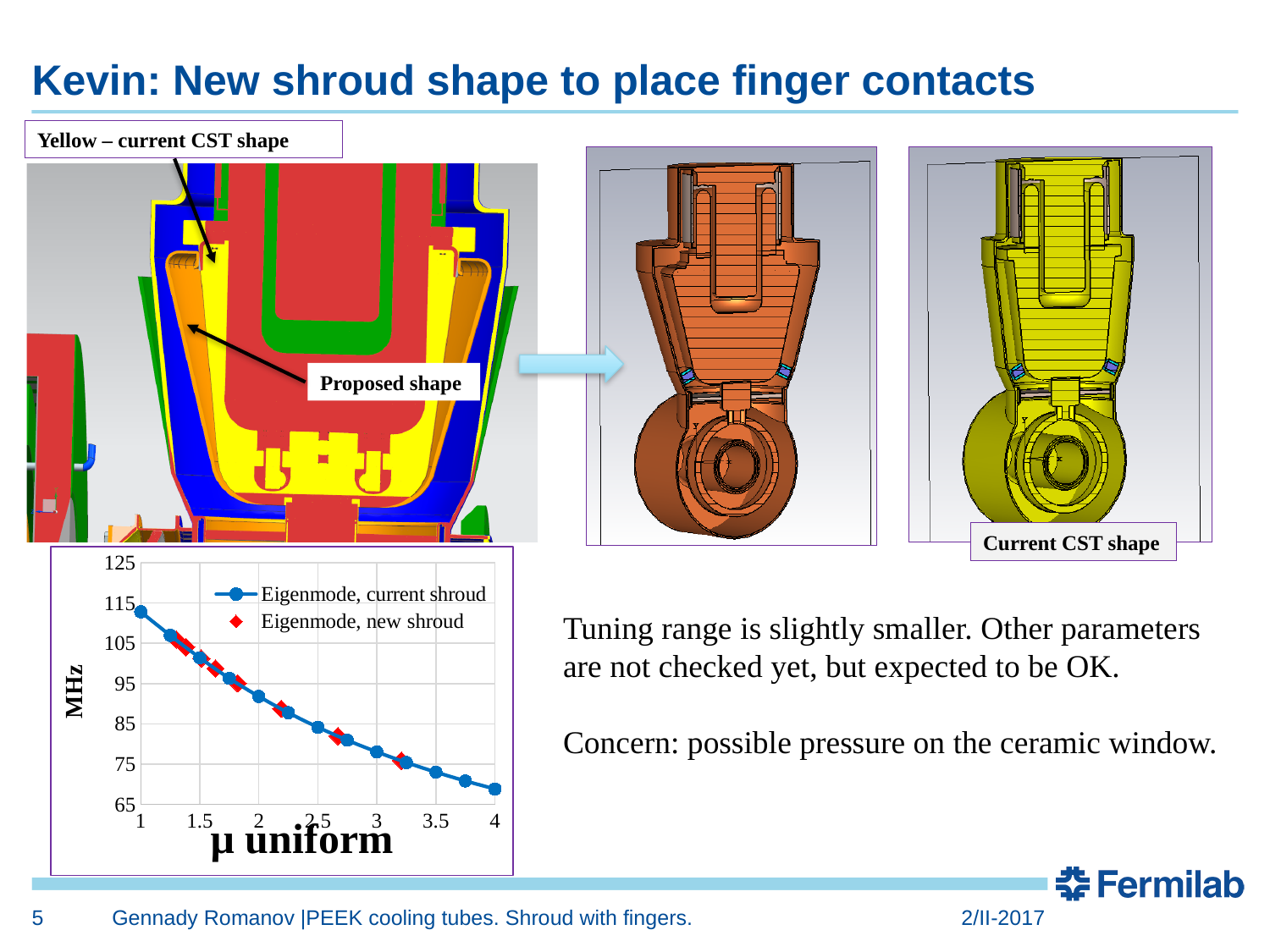
How many series does the chart legend list? 2 Which is larger for the current shroud: the value at μ uniform = 1 or at μ uniform = 4? μ uniform = 1 What kind of chart is shown on the slide? line chart Is the value for the current shroud at μ uniform = 4 greater or less than 75 MHz? less Is the value for the current shroud at μ uniform = 3 greater or less than 85 MHz? less Is the value for the current shroud at μ uniform = 1 greater or less than 105 MHz? greater What are the two series named in the chart legend? Eigenmode, current shroud; Eigenmode, new shroud At which μ uniform value does the current shroud series reach its lowest frequency? 4 What is the label of the chart's y axis? MHz At which μ uniform value does the current shroud series reach its highest frequency? 1 Do the frequency values rise or fall as μ uniform increases along the x axis? fall